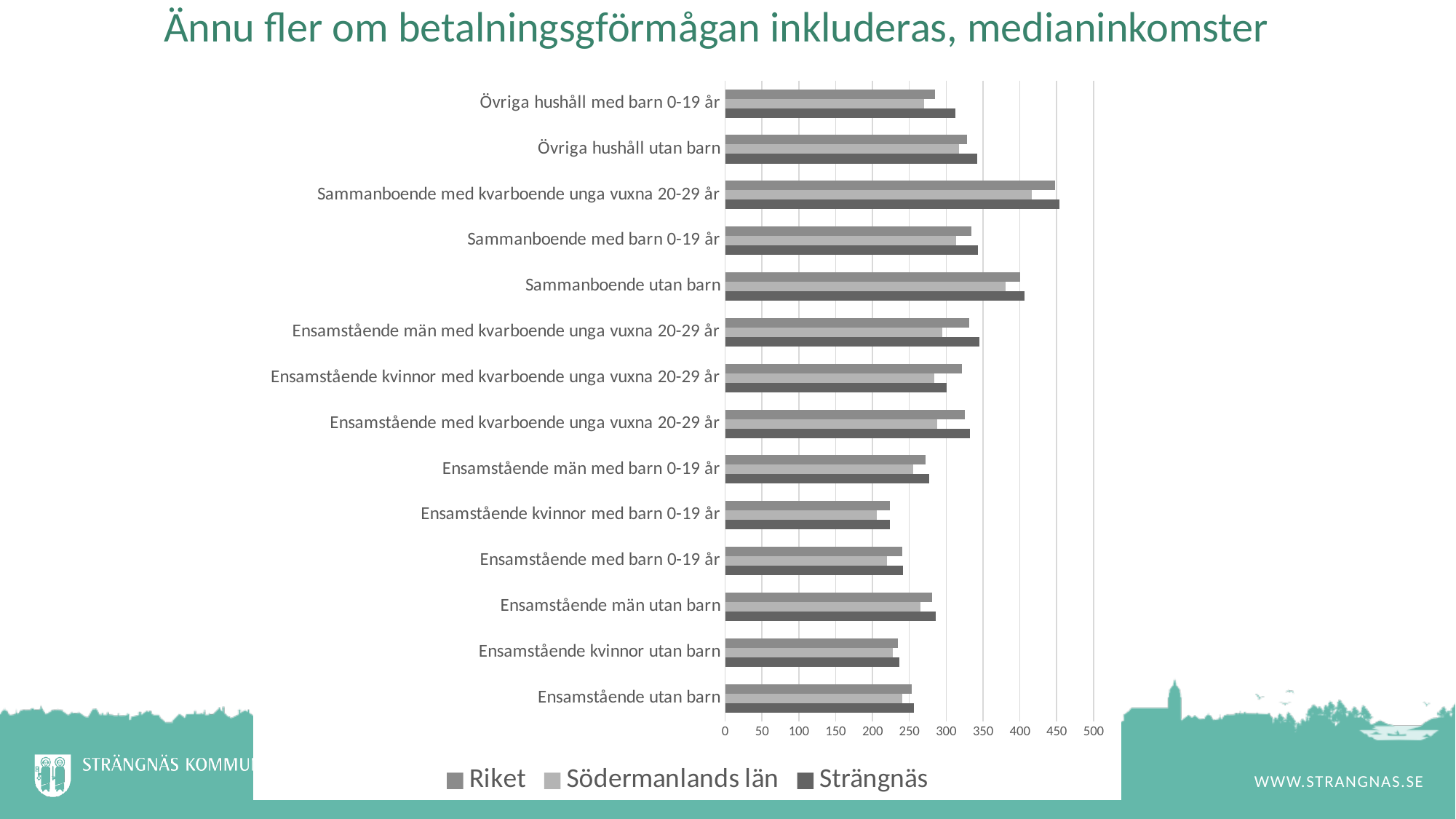
How many series does the legend list? 3 What is the title of the slide? Ännu fler om betalningsgförmågan inkluderas, medianinkomster What kind of chart is shown on the slide? Bar chart Is the Riket value for Sammanboende utan barn greater or less than 350? greater Which category has the lowest value for Södermanlands län? Ensamstående kvinnor med barn 0-19 år How many household categories are shown on the chart? 14 Which series are listed in the legend? Riket, Södermanlands län, Strängnäs Is the Strängnäs value for Sammanboende med kvarboende unga vuxna 20-29 år greater or less than 400? greater Which category has the highest value for Strängnäs? Sammanboende med kvarboende unga vuxna 20-29 år For Riket, which is larger: Ensamstående män med barn 0-19 år or Ensamstående kvinnor med barn 0-19 år? Ensamstående män med barn 0-19 år For Strängnäs, which is larger: Sammanboende utan barn or Ensamstående utan barn? Sammanboende utan barn Is the Södermanlands län value for Ensamstående kvinnor med barn 0-19 år greater or less than 250? less